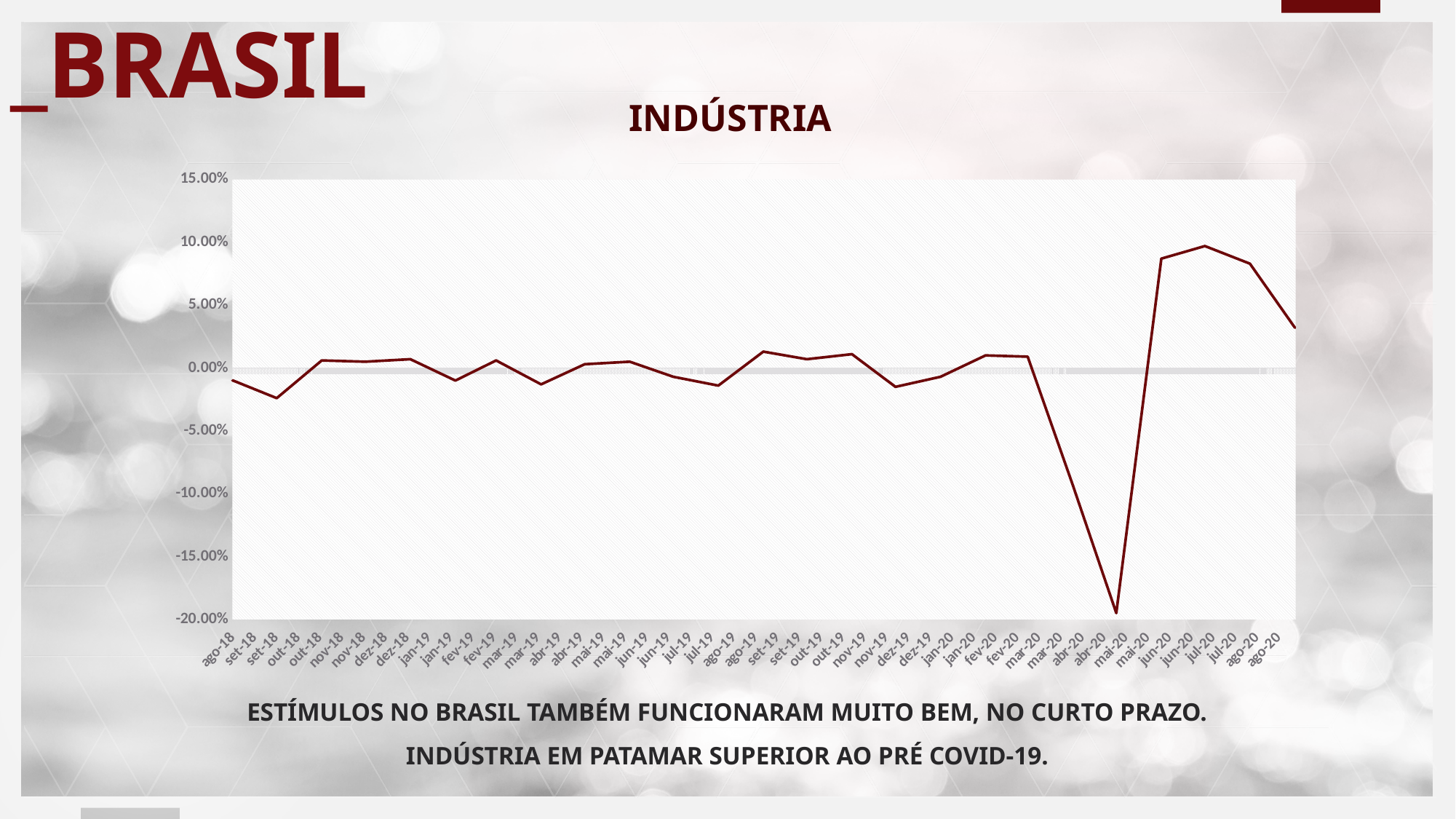
Is the value for set-18 greater or less than 0.00%? less What kind of chart is shown on the slide? line chart Is the value for mai-20 greater or less than -15.00%? greater Does the line rise or fall from jul-20 to ago-20? fall What is the highest value shown on the vertical axis? 15.00% Which month has the lowest value on the chart? abr-20 Which is larger, the value for jul-20 or the value for ago-20? jul-20 Is the value for jul-20 greater or less than 5.00%? greater Which month has the highest value on the chart? jun-20 What is the title of the chart? INDÚSTRIA Which is larger, the value for mar-20 or the value for mai-20? mai-20